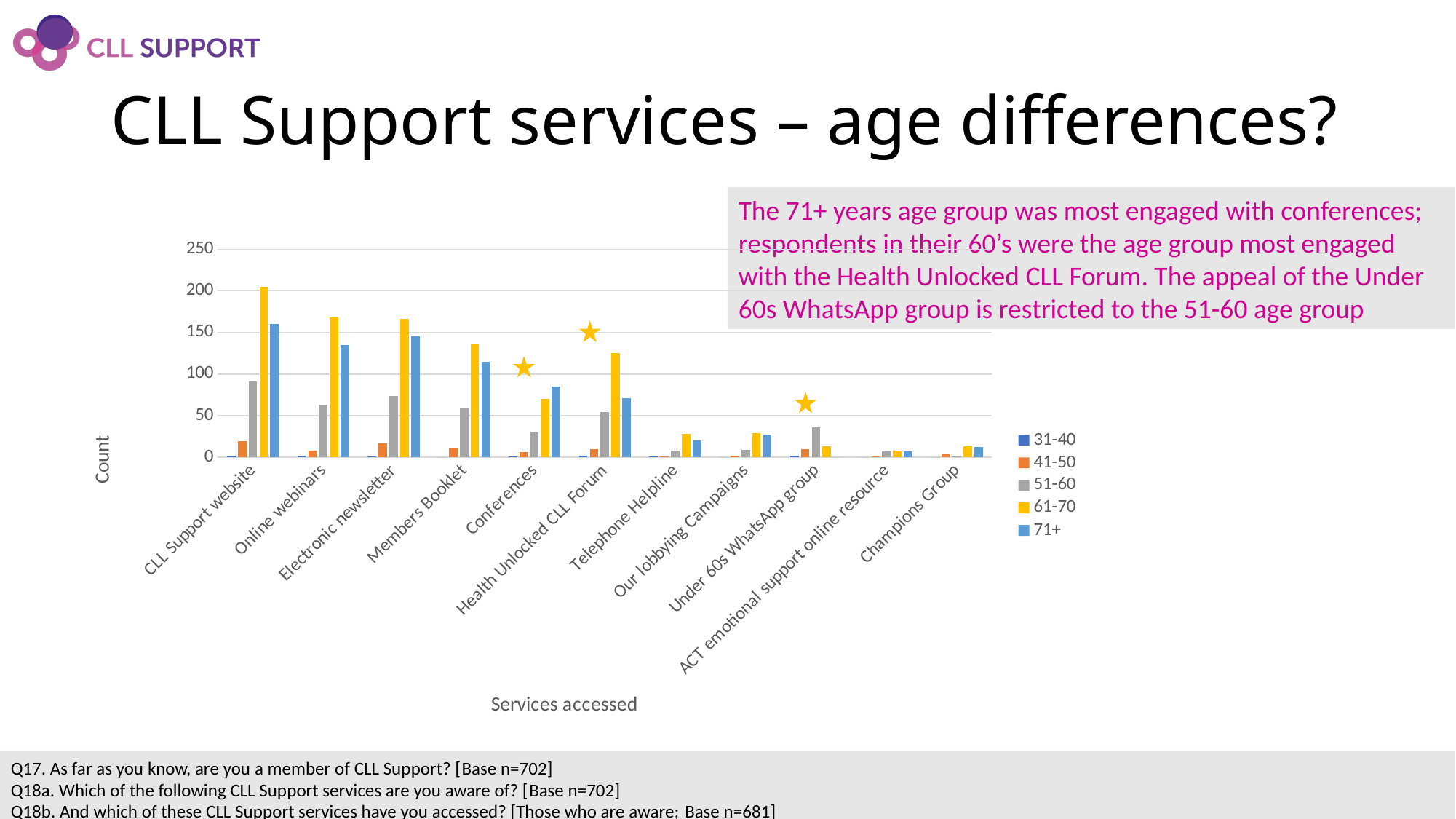
Is the value for the 61-70 age group for CLL Support website greater or less than 150? greater How many age groups does the chart legend list? 5 Is the value for the 51-60 age group for CLL Support website greater or less than 100? less For Conferences, which age group has the larger value: 61-70 or 71+? 71+ For Under 60s WhatsApp group, which age group has the larger value: 51-60 or 61-70? 51-60 How many services are listed along the x axis of the chart? 11 Is the value for the 51-60 age group for Under 60s WhatsApp group greater or less than 50? less For Online webinars, which age group has the tallest bar? 61-70 Which service has the tallest bar for the 61-70 age group? CLL Support website What is the title of the x axis of the chart? Services accessed What kind of chart is shown on the slide? Bar chart